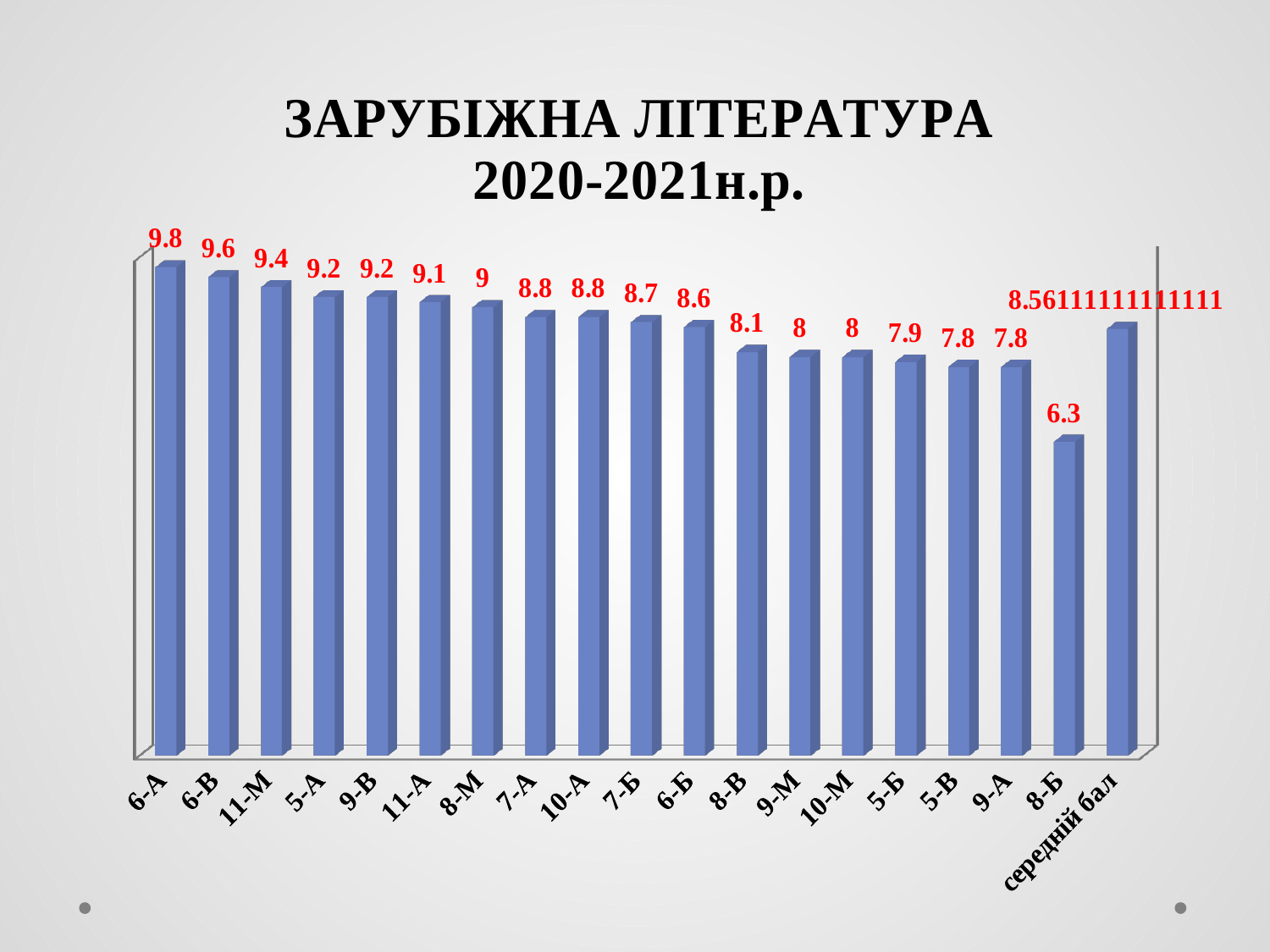
What is the title of the chart? ЗАРУБІЖНА ЛІТЕРАТУРА 2020-2021н.р. Which category has the lowest value? 8-Б What is the difference between the values for 6-А and 8-Б? 3.5 How many categories are shown on the x axis? 19 What is the value for 8-Б? 6.3 What kind of chart is shown on the slide? Bar chart What is the value shown for середній бал? 8.56111111111111 What is the value for 6-А? 9.8 What is the difference between the values for 6-В and 5-Б? 1.7 Which category has the highest value? 6-А Which is larger, the value for 7-Б or the value for 8-В? 7-Б What is the value for 11-М? 9.4